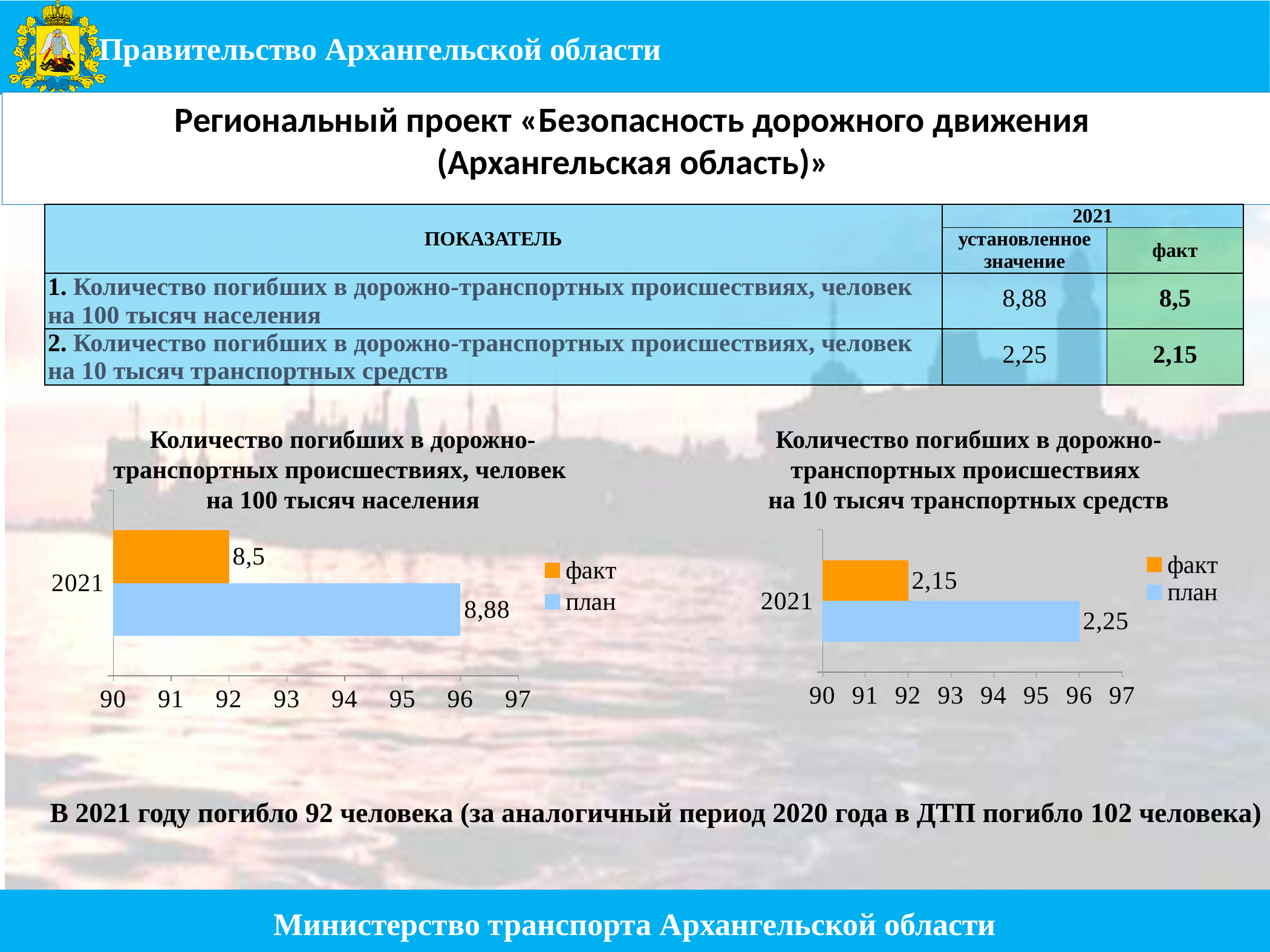
How many years (categories) are shown on the y axis of the left chart? 1 In the left chart (deaths per 100 thousand population), which is larger, факт or план? план In the right chart (deaths per 10 thousand vehicles), what is the value for план in 2021? 2,25 In the right chart (deaths per 10 thousand vehicles), what is the value for факт in 2021? 2,15 In the right chart (deaths per 10 thousand vehicles), which is larger, факт or план? план What kind of chart is the right chart (deaths per 10 thousand vehicles)? bar chart How many series does the legend of the left chart list? 2 In the right chart, which colour represents факт? orange In the left chart (deaths per 100 thousand population), what is the value for план in 2021? 8,88 In the left chart (deaths per 100 thousand population), what is the difference between план and факт? 0,38 In the left chart (deaths per 100 thousand population), what is the value for факт in 2021? 8,5 In the right chart (deaths per 10 thousand vehicles), what is the difference between план and факт? 0,1